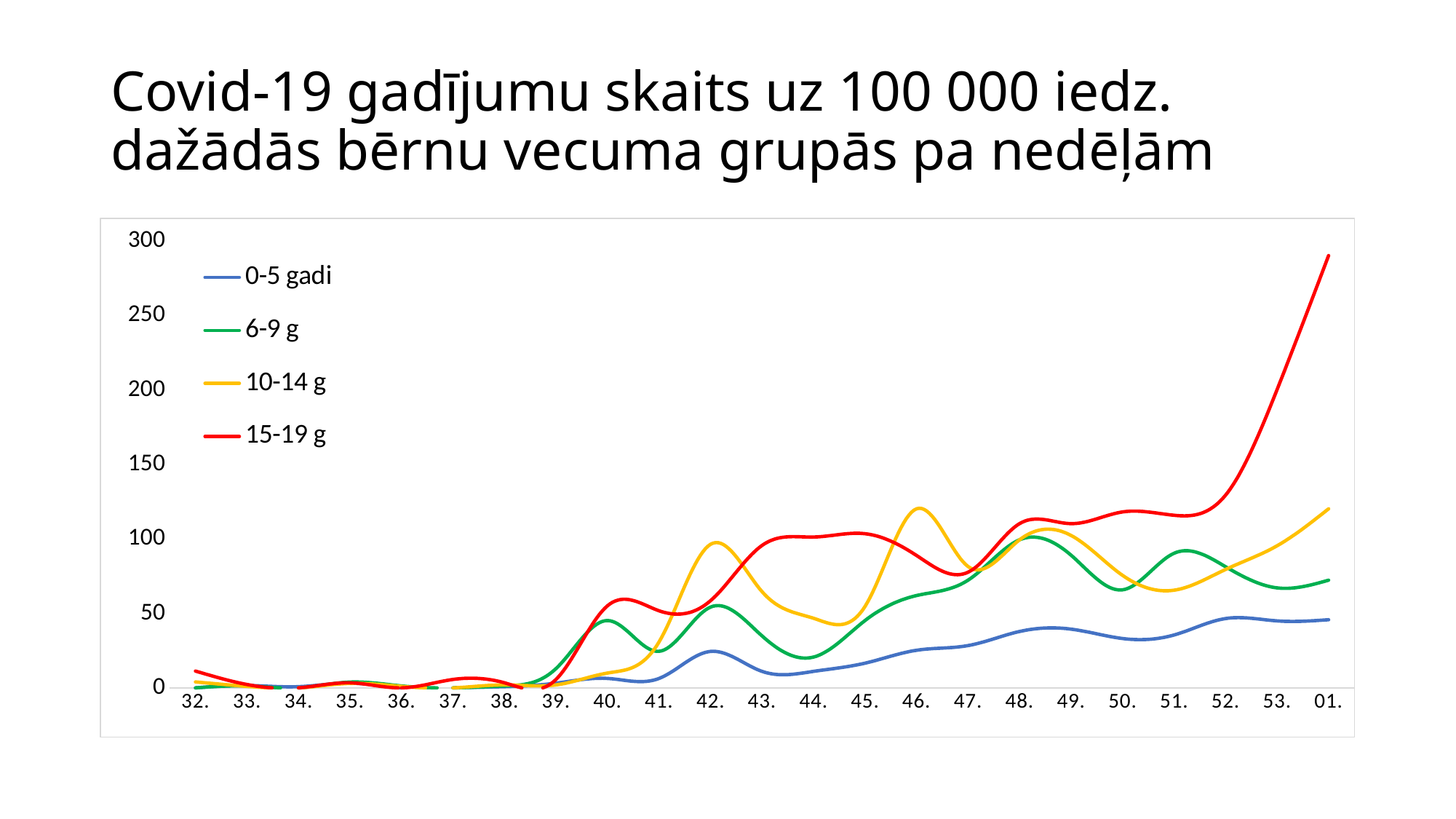
Which age group has the highest value at week 01.? 15-19 g Is the value for 10-14 g at week 46. greater or less than 100? greater At week 46., which is higher: 10-14 g or 15-19 g? 10-14 g Is the value for 0-5 gadi at week 01. greater or less than 50? less What kind of chart is shown on the slide? line chart Does the 15-19 g line rise or fall from week 51. to week 01.? rises Is the value for 15-19 g at week 01. greater or less than 250? greater At week 42., which is higher: 10-14 g or 6-9 g? 10-14 g How many series does the legend list? 4 Which age group has the lowest value at week 01.? 0-5 gadi How many weeks are plotted along the x axis? 23